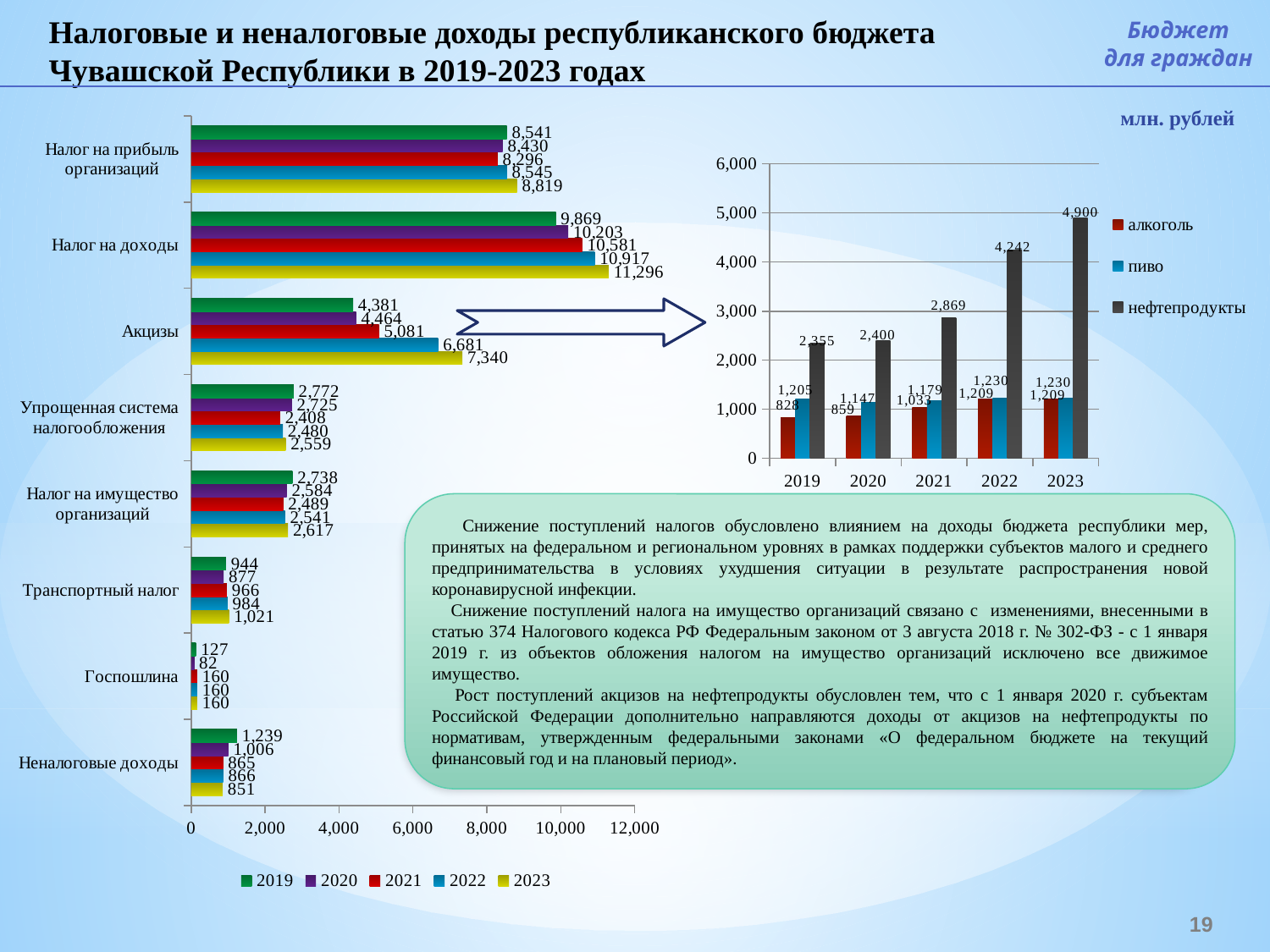
In the left chart, how many series does the legend list? 5 In the right chart, which year has the highest value for нефтепродукты? 2023 In the left chart, which category has the highest value in 2023? Налог на доходы In the right chart, what is the value for нефтепродукты in 2023? 4,900 In the left chart, what is the value for Налог на доходы in 2019? 9,869 In the left chart, which category has the lowest value in 2020? Госпошлина In the left chart, what is the difference between the 2023 and 2019 values for Акцизы? 2,959 In the left chart, how many categories are shown? 8 In the left chart, do the values for Налог на доходы rise or fall from 2019 to 2023? rise In the left chart, what is the value for Акцизы in 2023? 7,340 What kind of chart is the right chart? bar chart In the right chart, what is the difference between нефтепродукты in 2022 and 2021? 1,373